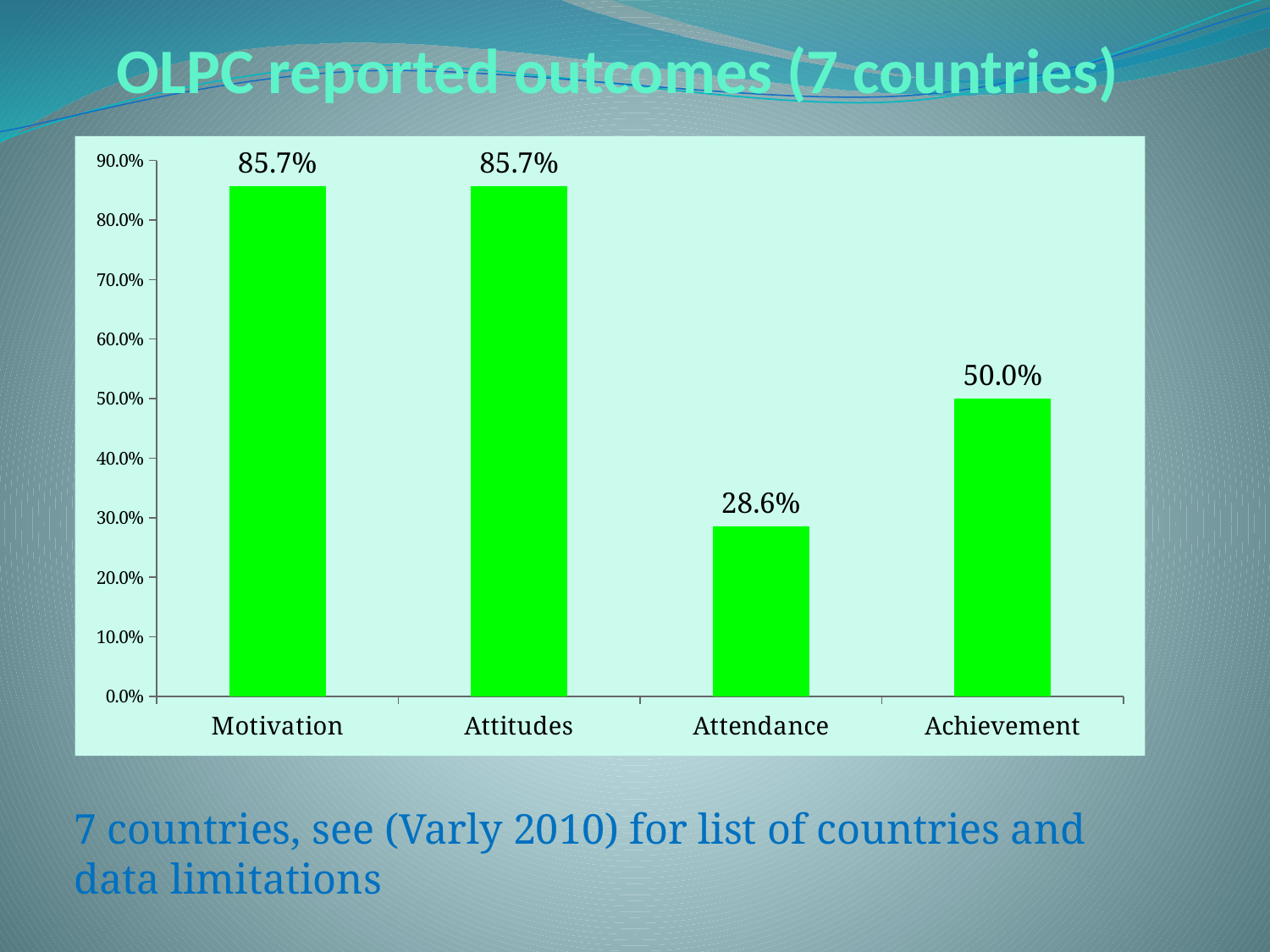
What is the value for Motivation? 85.7% What is the value for Attendance? 28.6% How many categories are shown in the chart? 4 What is the value for Attitudes? 85.7% What is the value for Achievement? 50.0% Which is larger, the value for Achievement or the value for Attendance? Achievement What is the title of the chart on the slide? OLPC reported outcomes (7 countries) Which category has the lowest value? Attendance What kind of chart is shown on the slide? bar chart What is the difference between the values for Motivation and Attendance? 57.1% What is the difference between the values for Achievement and Attendance? 21.4% Is the value for Achievement greater or less than 40.0%? greater